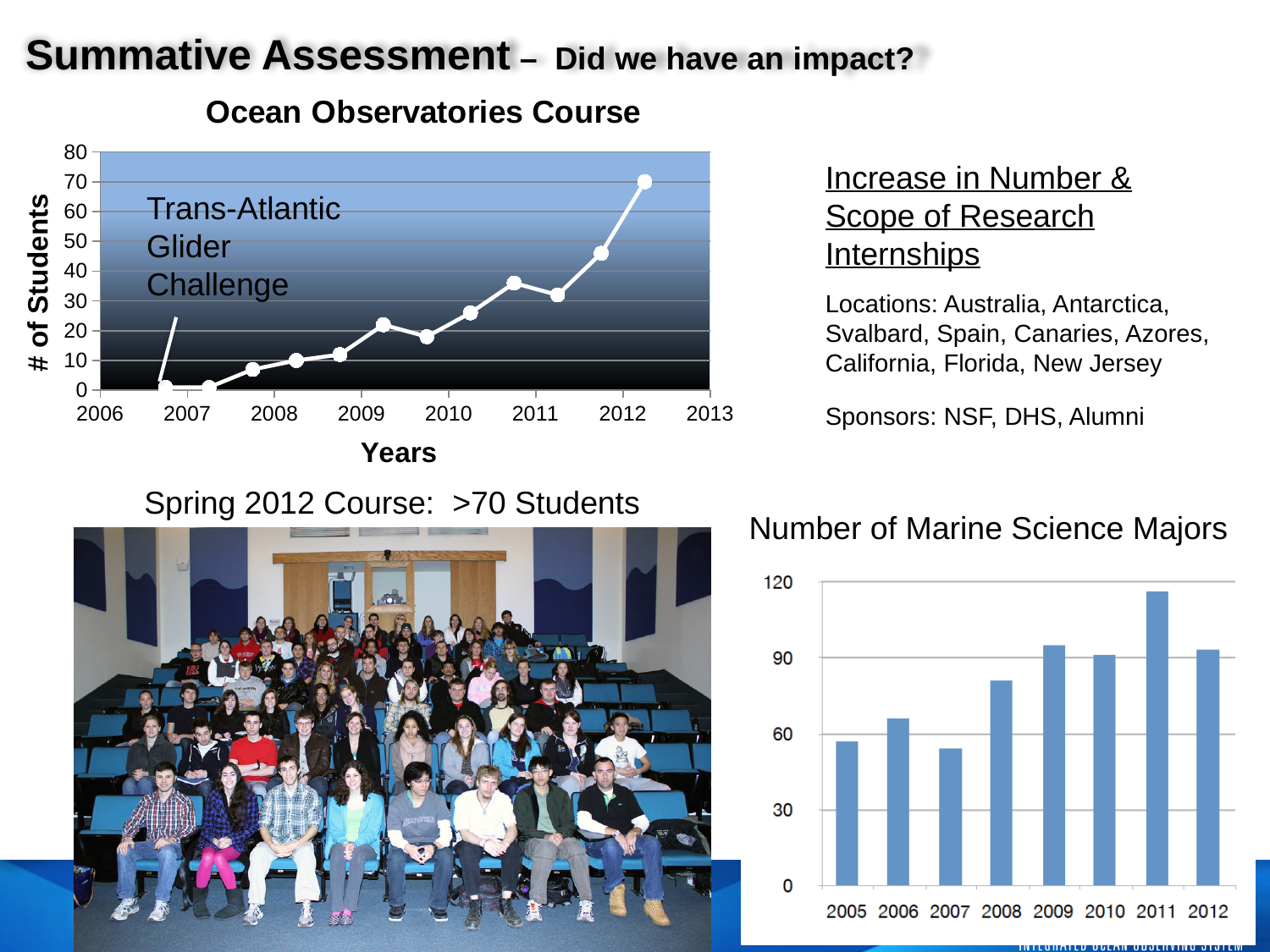
In the "Number of Marine Science Majors" chart, is the value for 2011 greater or less than 90? greater In the "Number of Marine Science Majors" chart, which is larger, the value for 2008 or the value for 2007? 2008 In the "Ocean Observatories Course" chart, how many data points are plotted? 12 In the "Number of Marine Science Majors" chart, is the value for 2005 greater or less than 60? less In the "Ocean Observatories Course" chart, is the highest point greater or less than 60? greater In the "Ocean Observatories Course" chart, do the values generally rise or fall over the years? rise In the "Number of Marine Science Majors" chart, which year has the highest value? 2011 What type of chart is the "Number of Marine Science Majors" chart? bar chart In the "Number of Marine Science Majors" chart, which is larger, the value for 2011 or the value for 2012? 2011 What is the y-axis label of the "Ocean Observatories Course" chart? # of Students What type of chart is the "Ocean Observatories Course" chart? line chart In the "Number of Marine Science Majors" chart, how many years are shown? 8